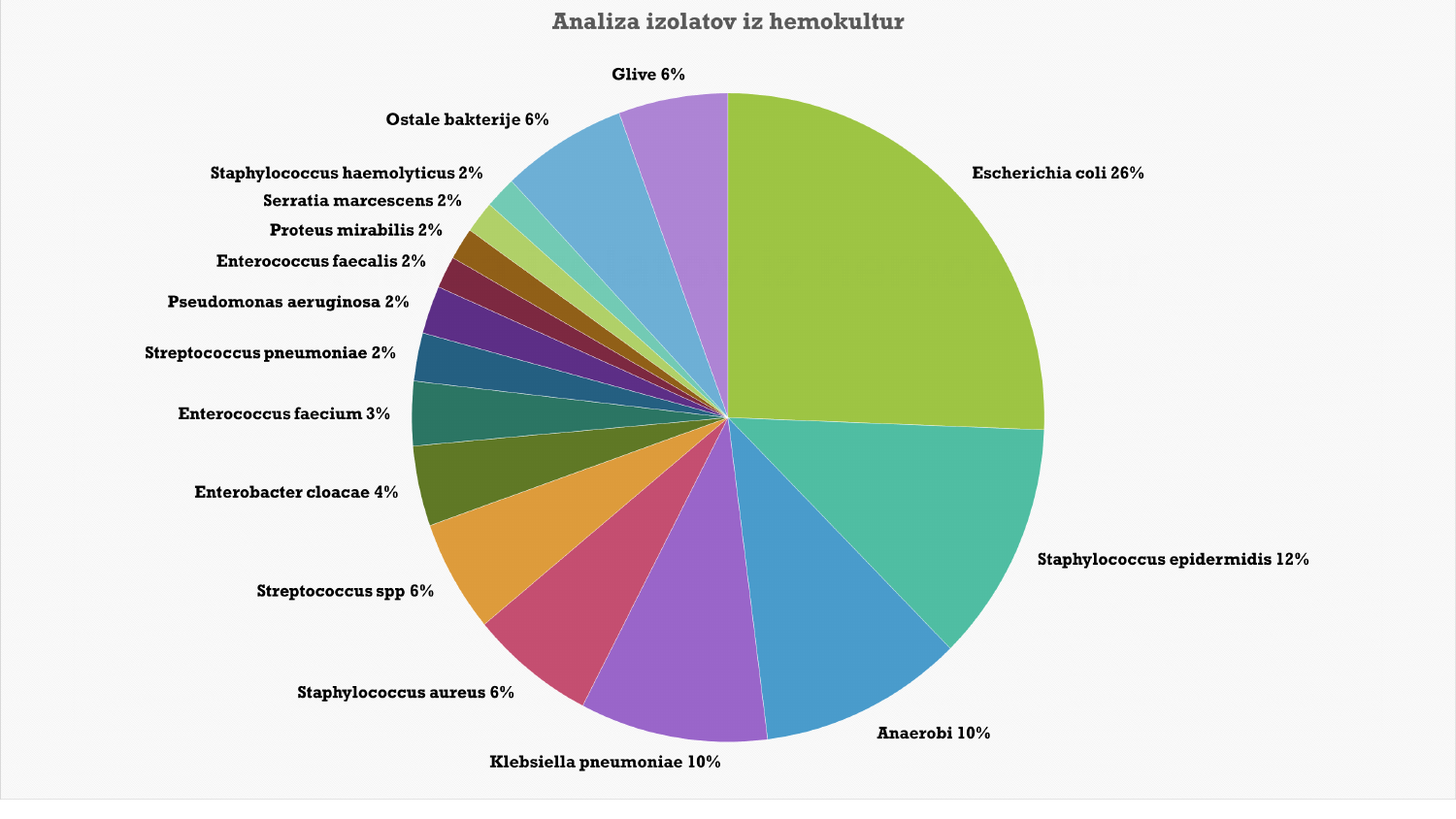
How many slices does the pie chart have? 16 What is the difference between the shares of Escherichia coli and Staphylococcus epidermidis? 14% What type of chart is shown on the slide? pie chart What is the value shown for Glive? 6% What share of the pie does Escherichia coli have? 26% Which is larger, the share for Anaerobi or the share for Staphylococcus aureus? Anaerobi What is the value shown for Enterobacter cloacae? 4% What is the title of the chart? Analiza izolatov iz hemokultur What is the value shown for Enterococcus faecium? 3% What is the value shown for Klebsiella pneumoniae? 10% What share of the pie does Staphylococcus epidermidis have? 12% Which category has the largest slice of the pie? Escherichia coli